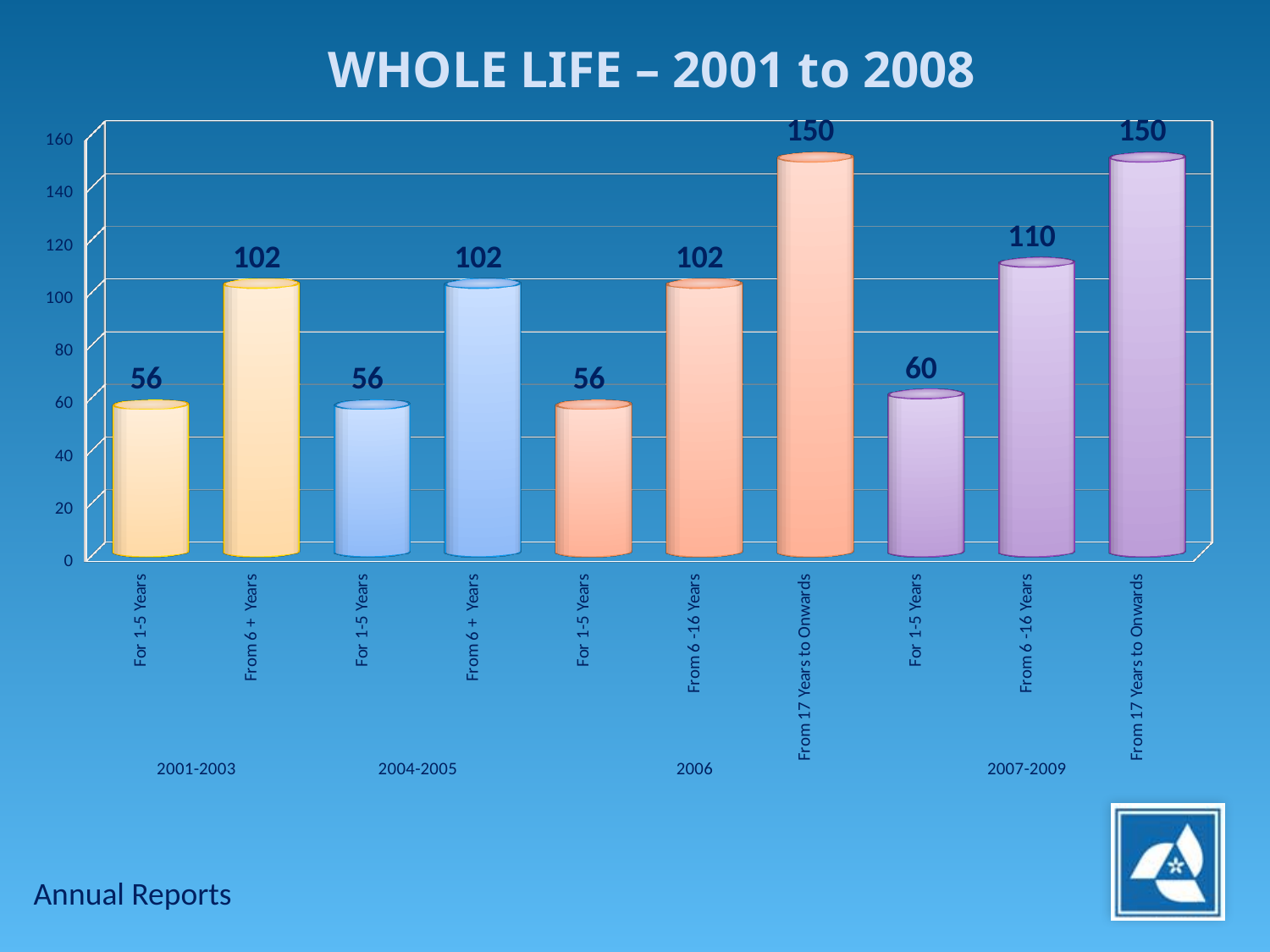
What is the difference between 'From 6 -16 Years' in 2007-2009 and 'From 6 -16 Years' in 2006? 8 What is the difference between 'From 17 Years to Onwards' and 'For 1-5 Years' in the 2006 group? 94 What is the value for 'From 6 + Years' in the 2004-2005 group? 102 What kind of chart is shown on the slide? Bar chart What is the value for 'From 17 Years to Onwards' in the 2006 group? 150 Which is larger: 'For 1-5 Years' in 2007-2009 or 'For 1-5 Years' in 2004-2005? For 1-5 Years in 2007-2009 What is the value for 'For 1-5 Years' in the 2007-2009 group? 60 What is the highest value shown on the chart? 150 What is the value for 'For 1-5 Years' in the 2001-2003 group? 56 What is the lowest value shown on the chart? 56 How many bars are plotted on the chart? 10 What is the value for 'From 6 -16 Years' in the 2007-2009 group? 110